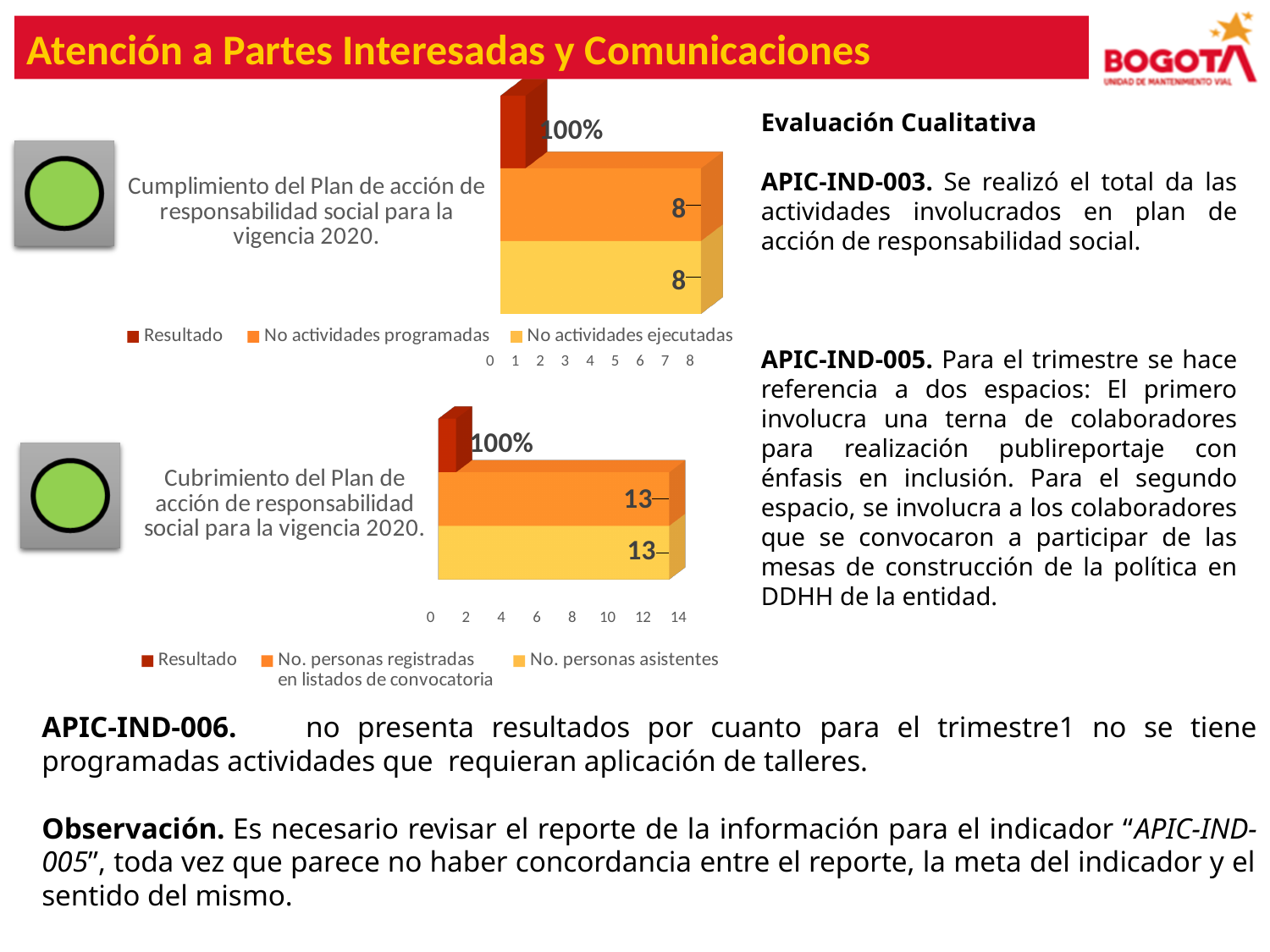
In the top chart (Cumplimiento del Plan de acción de responsabilidad social para la vigencia 2020), what is the value for 'No actividades ejecutadas'? 8 In the top chart (Cumplimiento del Plan de acción de responsabilidad social para la vigencia 2020), what is the value labelled for 'Resultado'? 100% In the bottom chart (Cubrimiento del Plan de acción de responsabilidad social para la vigencia 2020), what is the value labelled for 'Resultado'? 100% How many series does the legend of the top chart (Cumplimiento del Plan de acción de responsabilidad social para la vigencia 2020) list? 3 In the top chart (Cumplimiento del Plan de acción de responsabilidad social para la vigencia 2020), what is the difference between 'No actividades programadas' and 'No actividades ejecutadas'? 0 What kind of chart is the bottom chart (Cubrimiento del Plan de acción de responsabilidad social para la vigencia 2020)? Bar chart How many series does the legend of the bottom chart (Cubrimiento del Plan de acción de responsabilidad social para la vigencia 2020) list? 3 In the bottom chart (Cubrimiento del Plan de acción de responsabilidad social para la vigencia 2020), what is the value for 'No. personas asistentes'? 13 In the bottom chart (Cubrimiento del Plan de acción de responsabilidad social para la vigencia 2020), what is the difference between 'No. personas registradas en listados de convocatoria' and 'No. personas asistentes'? 0 In the bottom chart (Cubrimiento del Plan de acción de responsabilidad social para la vigencia 2020), what is the highest value shown on the horizontal axis? 14 In the top chart (Cumplimiento del Plan de acción de responsabilidad social para la vigencia 2020), what is the value for 'No actividades programadas'? 8 In the bottom chart (Cubrimiento del Plan de acción de responsabilidad social para la vigencia 2020), what is the value for 'No. personas registradas en listados de convocatoria'? 13